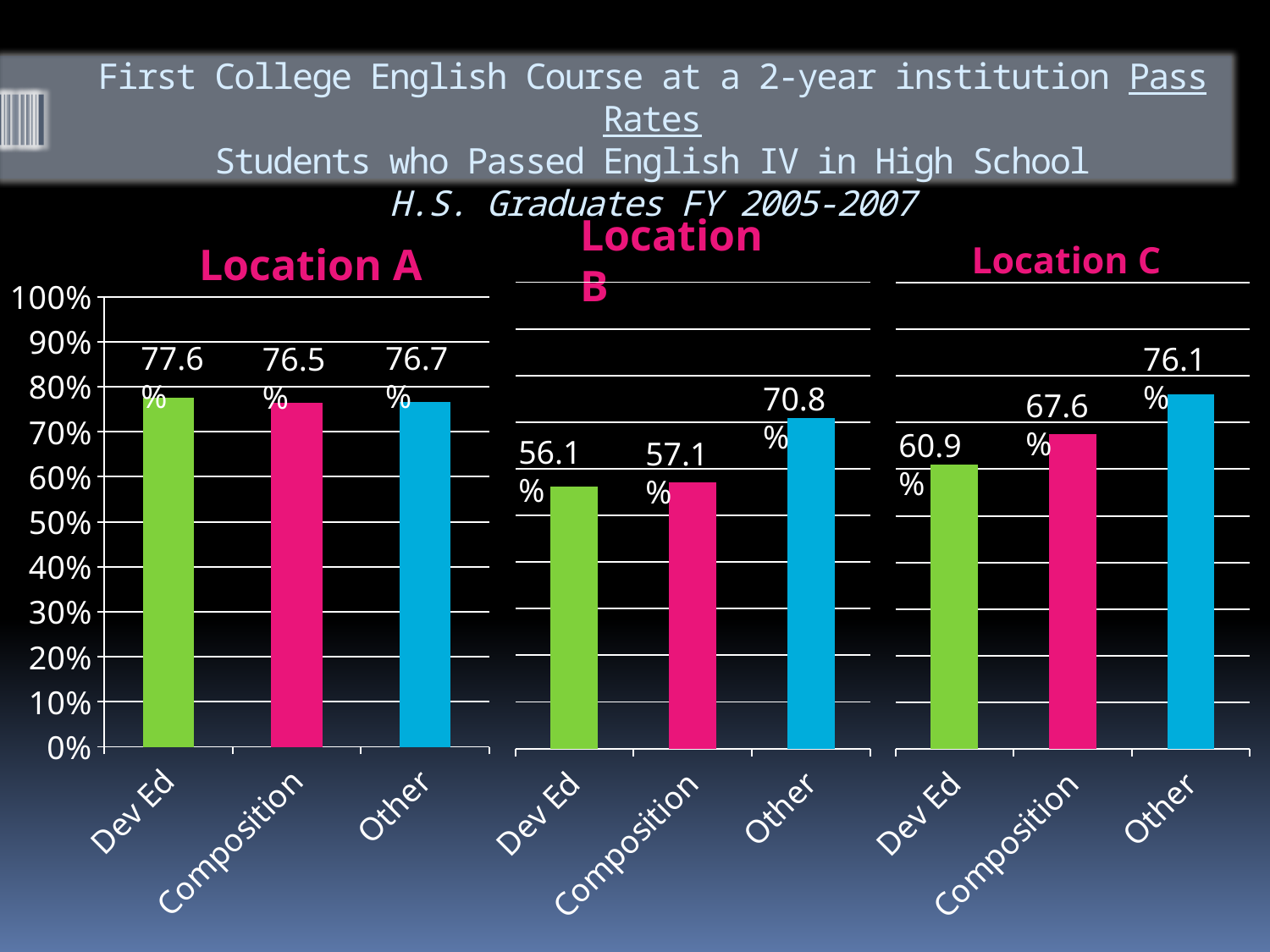
In the Location B chart, which category has the highest value? Other In the Location B chart, what is the difference between the Other and Composition values? 13.7% In the Location C chart, what is the value for Composition? 67.6% In the Location B chart, what is the value for Other? 70.8% How many categories are shown in the Location C chart? 3 What kind of chart is the Location A chart? bar chart In the Location C chart, which category has the lowest value? Dev Ed In the Location C chart, do the values rise or fall from Dev Ed to Other? rise In the Location B chart, which is larger, the value for Dev Ed or the value for Other? Other In the Location A chart, what is the value for Dev Ed? 77.6% In the Location C chart, what is the difference between the Other and Dev Ed values? 15.2% In the Location A chart, is the value for Composition greater or less than 70%? greater